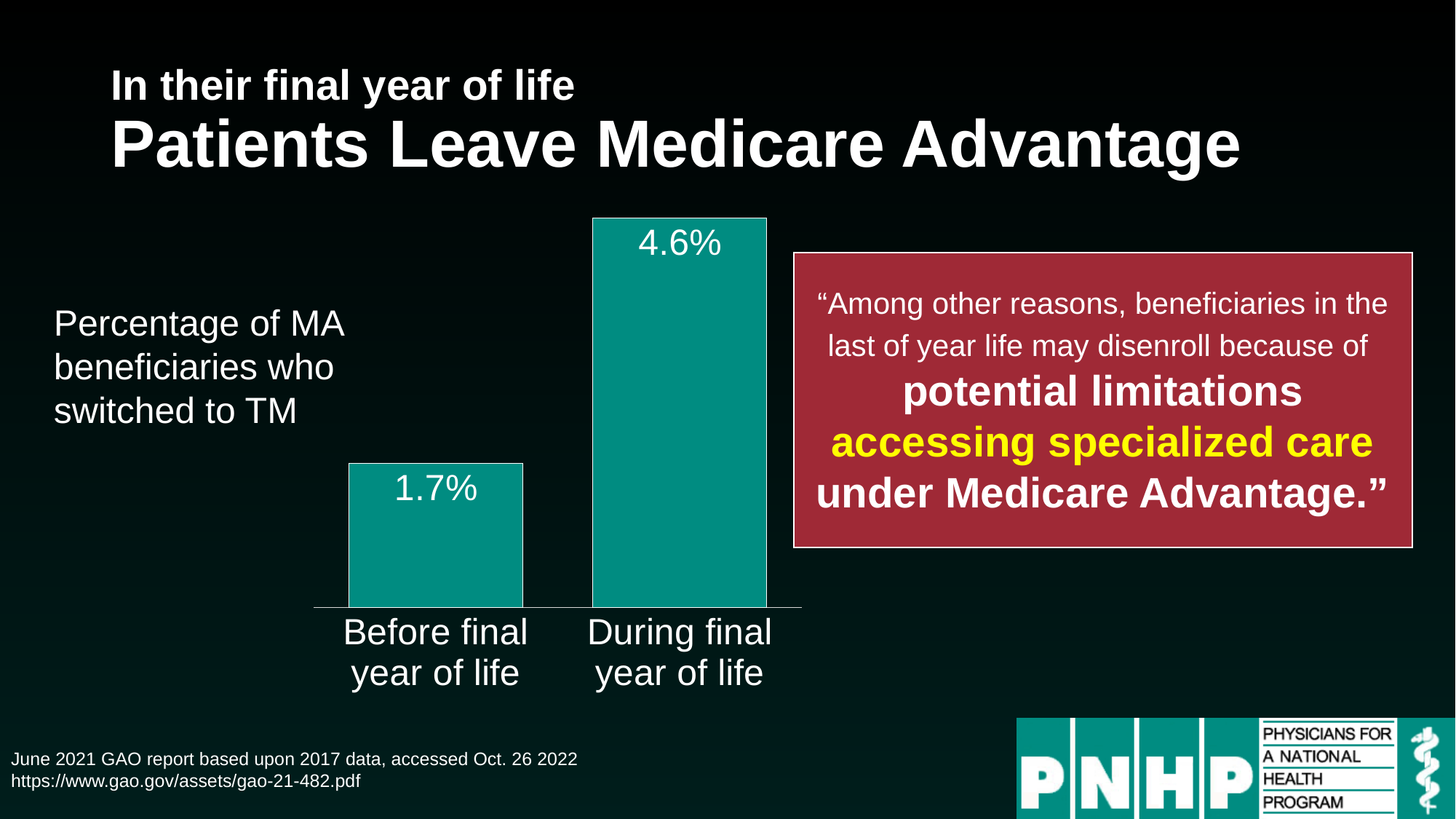
Which category has the lower percentage of MA beneficiaries who switched to TM? Before final year of life What percentage of MA beneficiaries switched to TM during their final year of life? 4.6% Which category has the higher percentage of MA beneficiaries who switched to TM? During final year of life Do the values rise or fall from 'Before final year of life' to 'During final year of life'? rise What percentage of MA beneficiaries switched to TM before their final year of life? 1.7% What does the chart measure, according to the label to its left? Percentage of MA beneficiaries who switched to TM What is the difference in percentage points between the 'During final year of life' and 'Before final year of life' bars? 2.9 What kind of chart is shown on the slide? bar chart Is the value for 'Before final year of life' larger or smaller than the value for 'During final year of life'? smaller What colour are the bars in the chart? teal How many categories are shown in the bar chart? 2